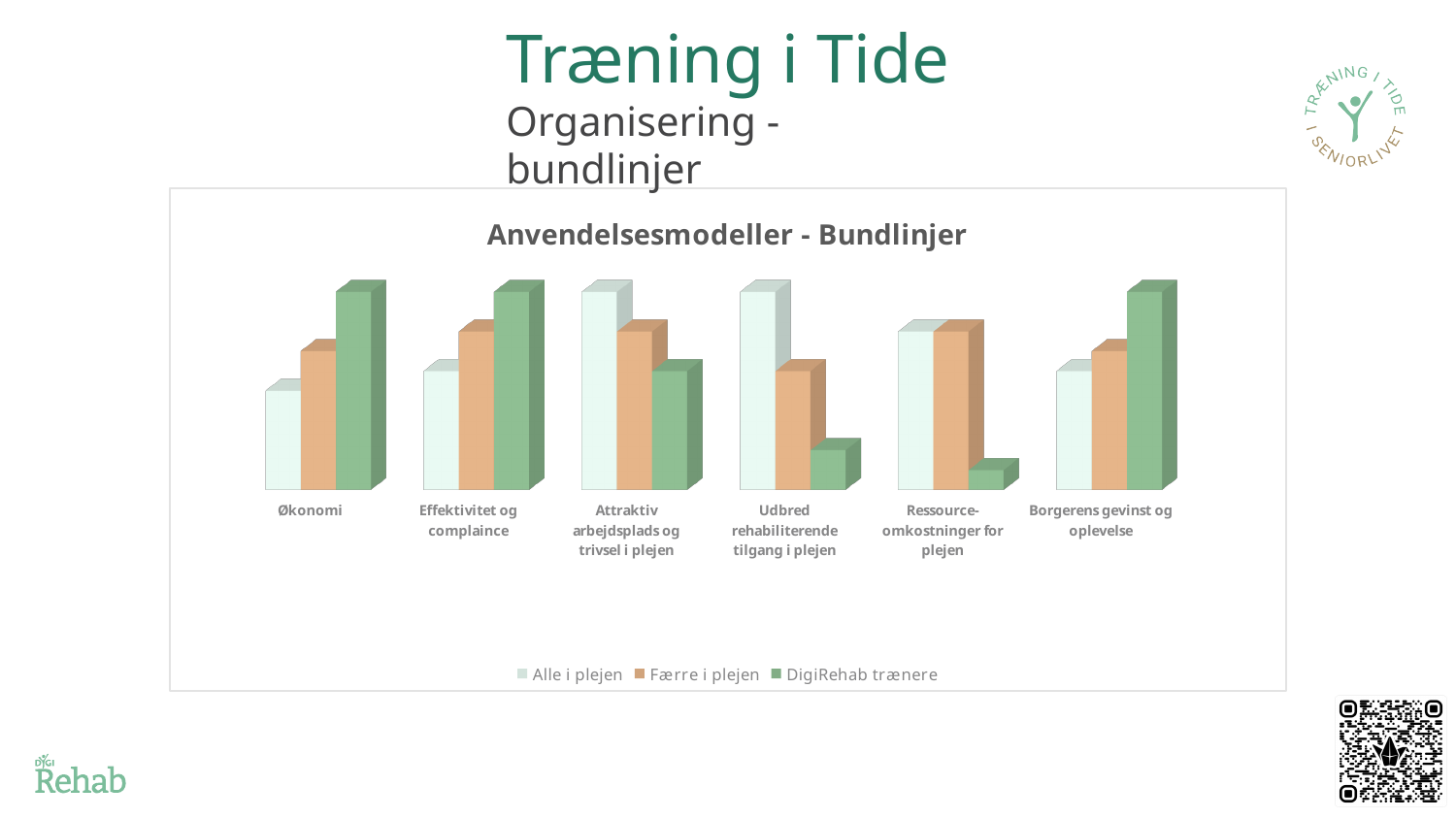
For the category Økonomi, which series has the tallest bar? DigiRehab trænere How many series does the chart's legend list? 3 In the category Ressource-omkostninger for plejen, which is larger: Alle i plejen or DigiRehab trænere? Alle i plejen For the category Effektivitet og complaince, which series has the shortest bar? Alle i plejen What is the title of the chart? Anvendelsesmodeller - Bundlinjer In which category is the DigiRehab trænere bar the lowest? Ressource-omkostninger for plejen What kind of chart is shown on the slide? bar chart For the category Borgerens gevinst og oplevelse, which series has the tallest bar? DigiRehab trænere For the category Udbred rehabiliterende tilgang i plejen, which series has the shortest bar? DigiRehab trænere How many categories are shown along the x axis of the chart? 6 Which series does the legend list last? DigiRehab trænere For the category Attraktiv arbejdsplads og trivsel i plejen, which series has the tallest bar? Alle i plejen